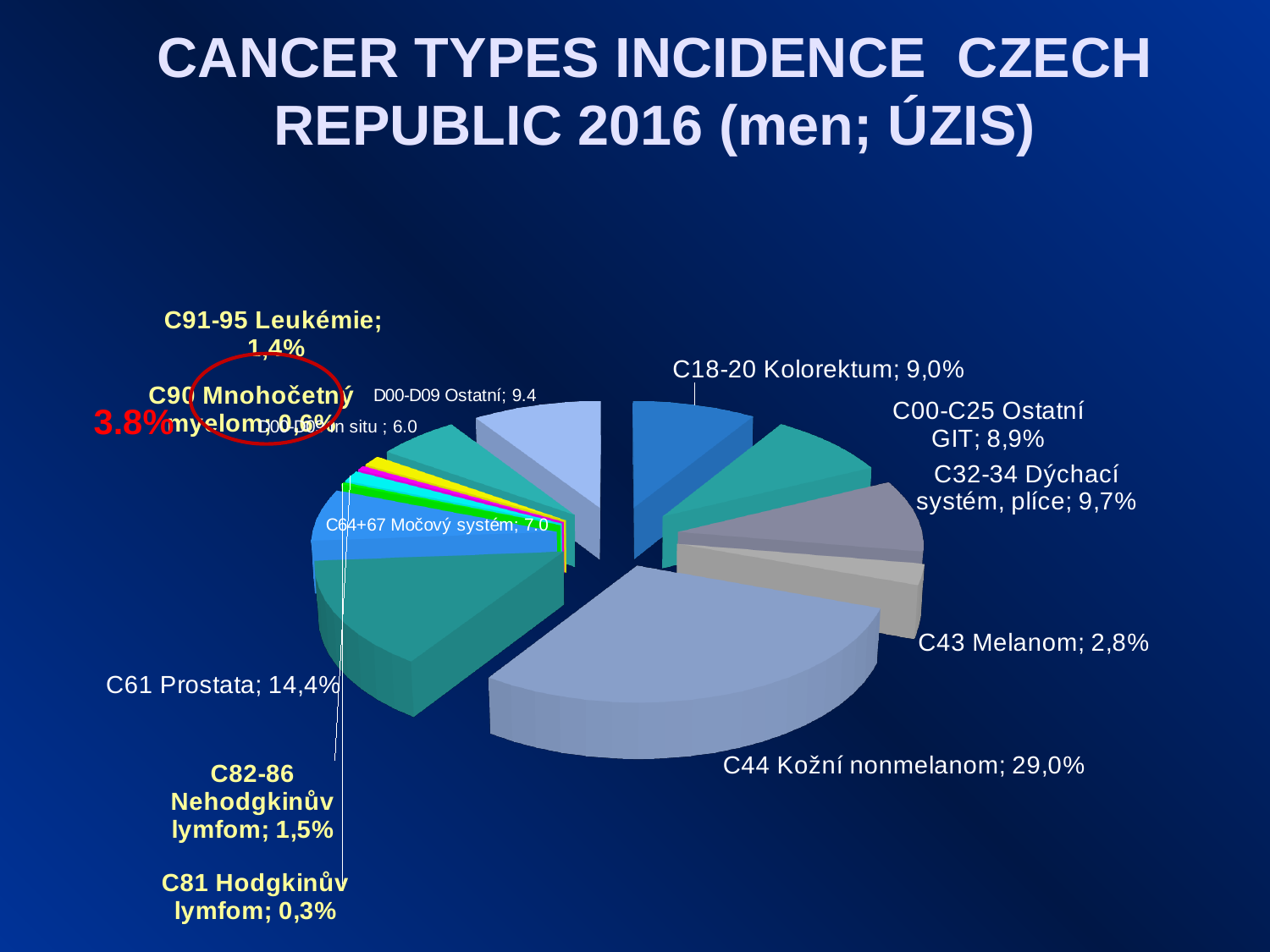
Which is larger, the share for C18-20 Kolorektum or the share for C00-C25 Ostatní GIT? C18-20 Kolorektum What is the share for C82-86 Nehodgkinův lymfom? 1,5% Which category has the smallest share of the pie? C81 Hodgkinův lymfom Which is larger, the share for C91-95 Leukémie or the share for C82-86 Nehodgkinův lymfom? C82-86 Nehodgkinův lymfom What kind of chart is shown on the slide? pie chart What is the title of the slide? CANCER TYPES INCIDENCE CZECH REPUBLIC 2016 (men; ÚZIS) What is the difference in percentage points between C61 Prostata and C18-20 Kolorektum? 5,4 What is the share for C43 Melanom? 2,8% What is the share for C32-34 Dýchací systém, plíce? 9,7% What is the share for C61 Prostata? 14,4% Which category has the largest share of the pie? C44 Kožní nonmelanom What is the share for C44 Kožní nonmelanom? 29,0%